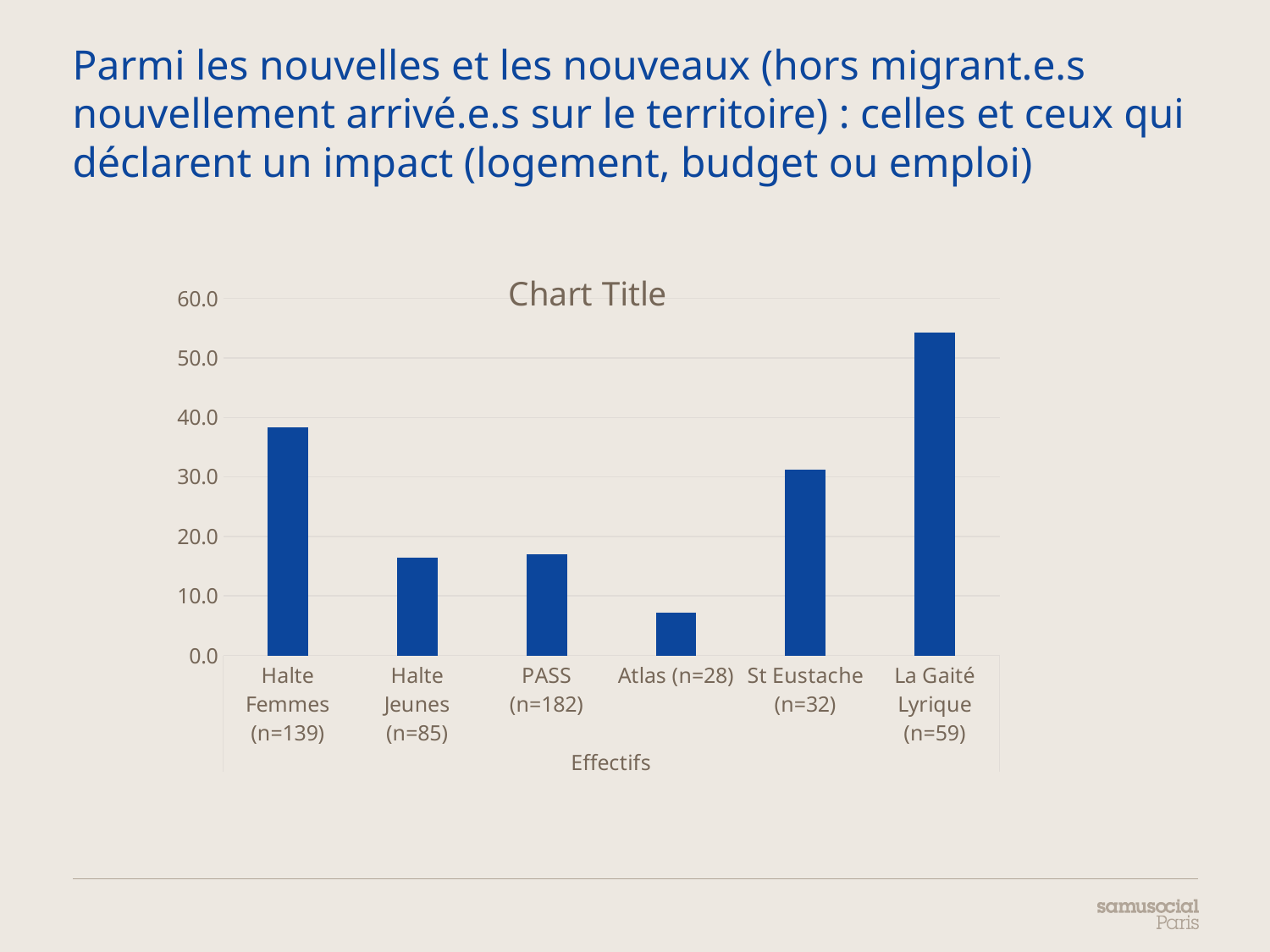
Which category has the highest bar in the chart? La Gaité Lyrique (n=59) Which category has the lowest bar in the chart? Atlas (n=28) What is the label shown on the x axis of the chart? Effectifs Is the value for St Eustache (n=32) greater or less than 30.0? greater Is the value for La Gaité Lyrique (n=59) greater or less than 50.0? greater Is the value for Halte Jeunes (n=85) greater or less than 20.0? less How many categories are shown on the x axis of the chart? 6 Which is larger, the value for Halte Femmes (n=139) or the value for St Eustache (n=32)? Halte Femmes (n=139) What kind of chart is shown on the slide? bar chart Which is larger, the value for PASS (n=182) or the value for Atlas (n=28)? PASS (n=182)